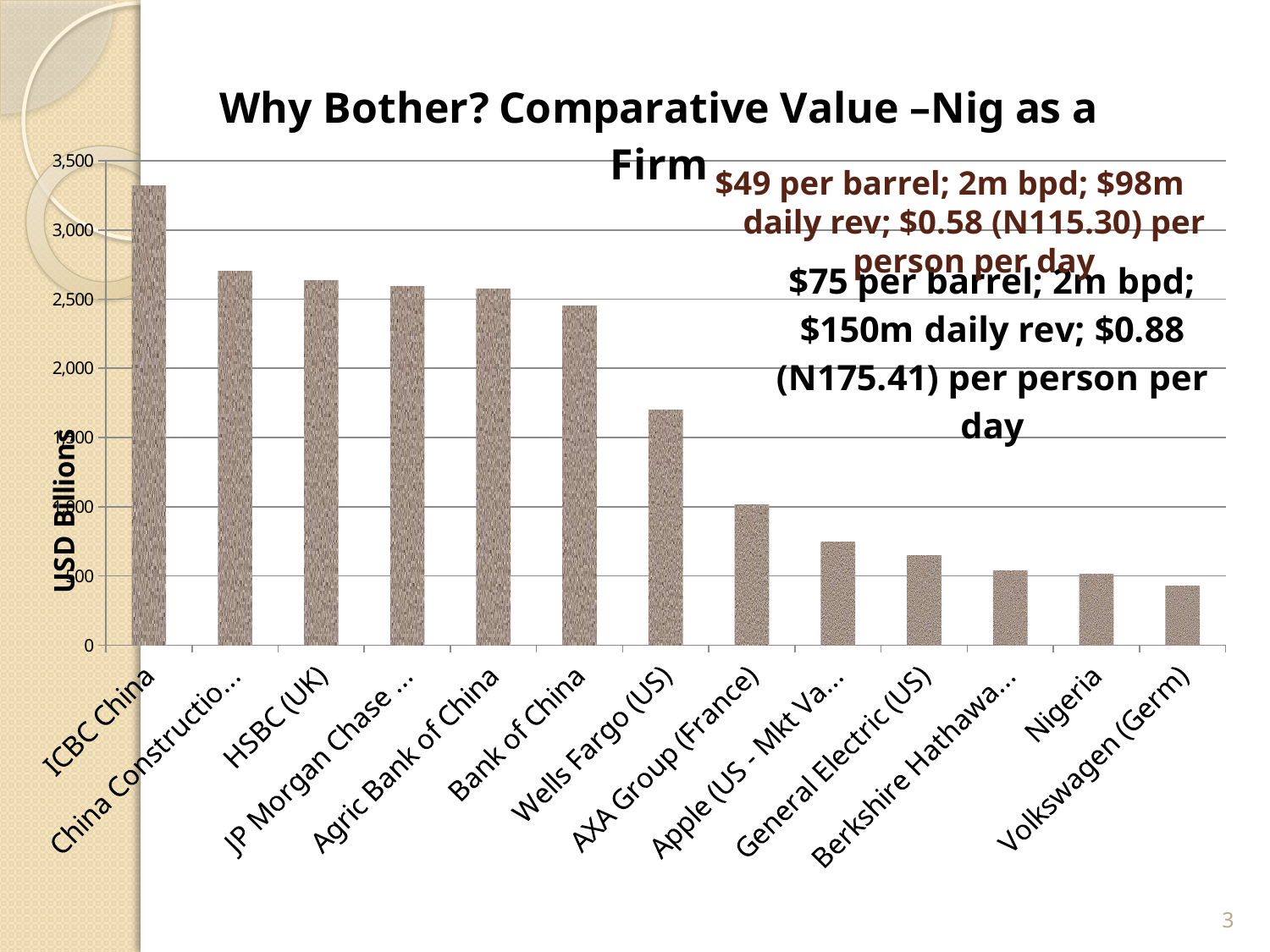
Is the value for General Electric (US) greater or less than 500? greater Is the value for Volkswagen (Germ) greater or less than 500? less What is the label on the vertical axis? USD Billions Is the value for Nigeria greater or less than 1,000? less Do the bar values rise or fall moving from left to right along the x axis? fall Which category has the highest bar? ICBC China Which category has the lowest bar? Volkswagen (Germ) What kind of chart is shown on the slide? bar chart How many categories are plotted on the x axis? 13 Which is larger, the value for Wells Fargo (US) or the value for AXA Group (France)? Wells Fargo (US)